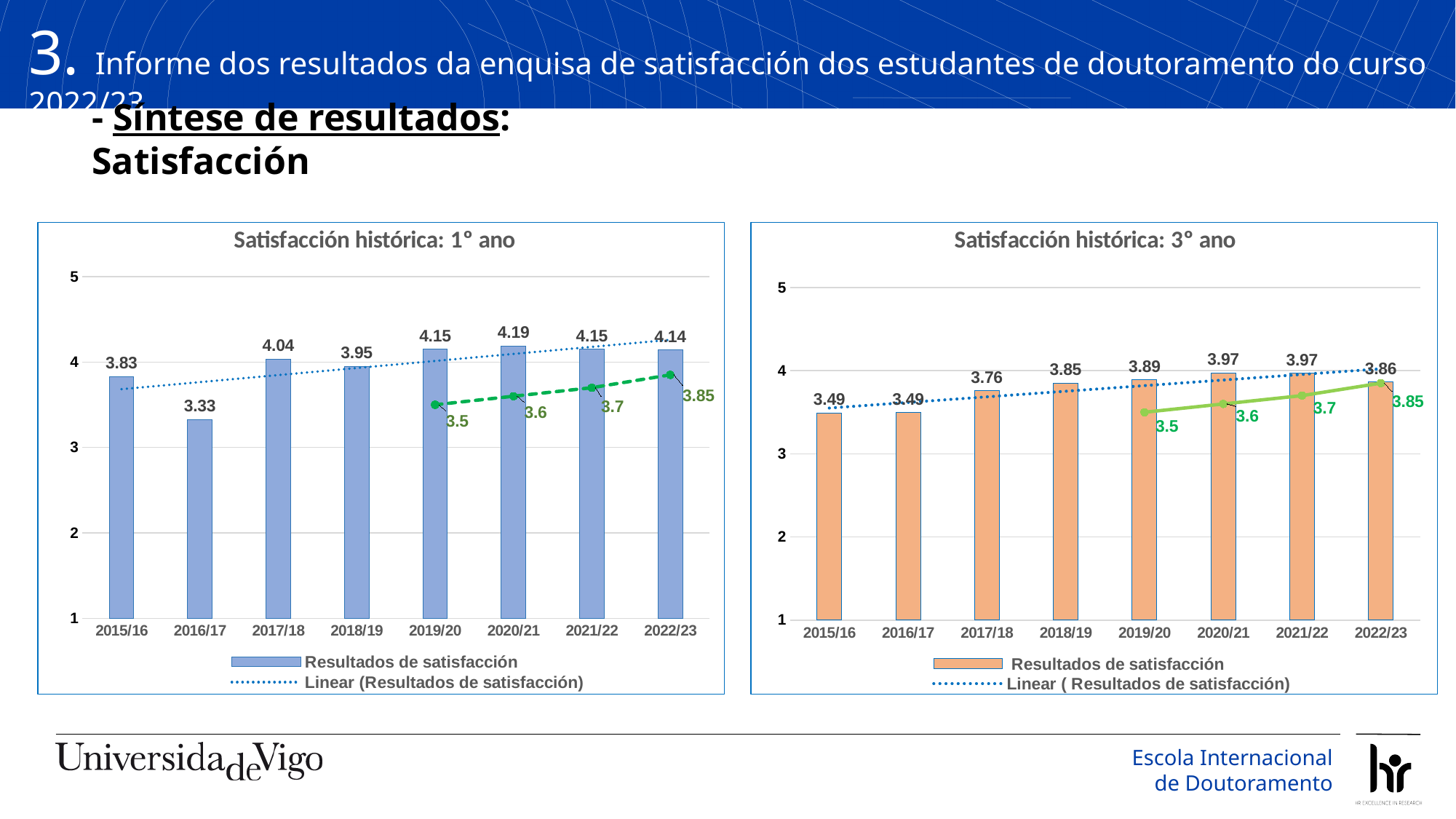
In the 'Satisfacción histórica: 3° ano' chart, which year has the lowest satisfaction result? 2015/16 and 2016/17 (both 3.49) In the 'Satisfacción histórica: 1° ano' chart, which year has the highest satisfaction result? 2020/21 In the 'Satisfacción histórica: 3° ano' chart, what is the difference between the 2020/21 and 2015/16 satisfaction results? 0.48 What type of chart is 'Satisfacción histórica: 3° ano'? Combination bar and line chart In the 'Satisfacción histórica: 3° ano' chart, is the satisfaction result for 2018/19 larger than the result for 2022/23? No How many entries does the legend of the 'Satisfacción histórica: 1° ano' chart list? 2 In the 'Satisfacción histórica: 3° ano' chart, what is the satisfaction result for 2017/18? 3.76 How many years are shown on the x axis of the 'Satisfacción histórica: 1° ano' chart? 8 In the 'Satisfacción histórica: 3° ano' chart, what is the satisfaction result for 2022/23? 3.86 In the 'Satisfacción histórica: 1° ano' chart, what is the satisfaction result for 2016/17? 3.33 In the 'Satisfacción histórica: 1° ano' chart, what is the difference between the 2017/18 and 2016/17 satisfaction results? 0.71 In the 'Satisfacción histórica: 1° ano' chart, which year has the lowest satisfaction result? 2016/17